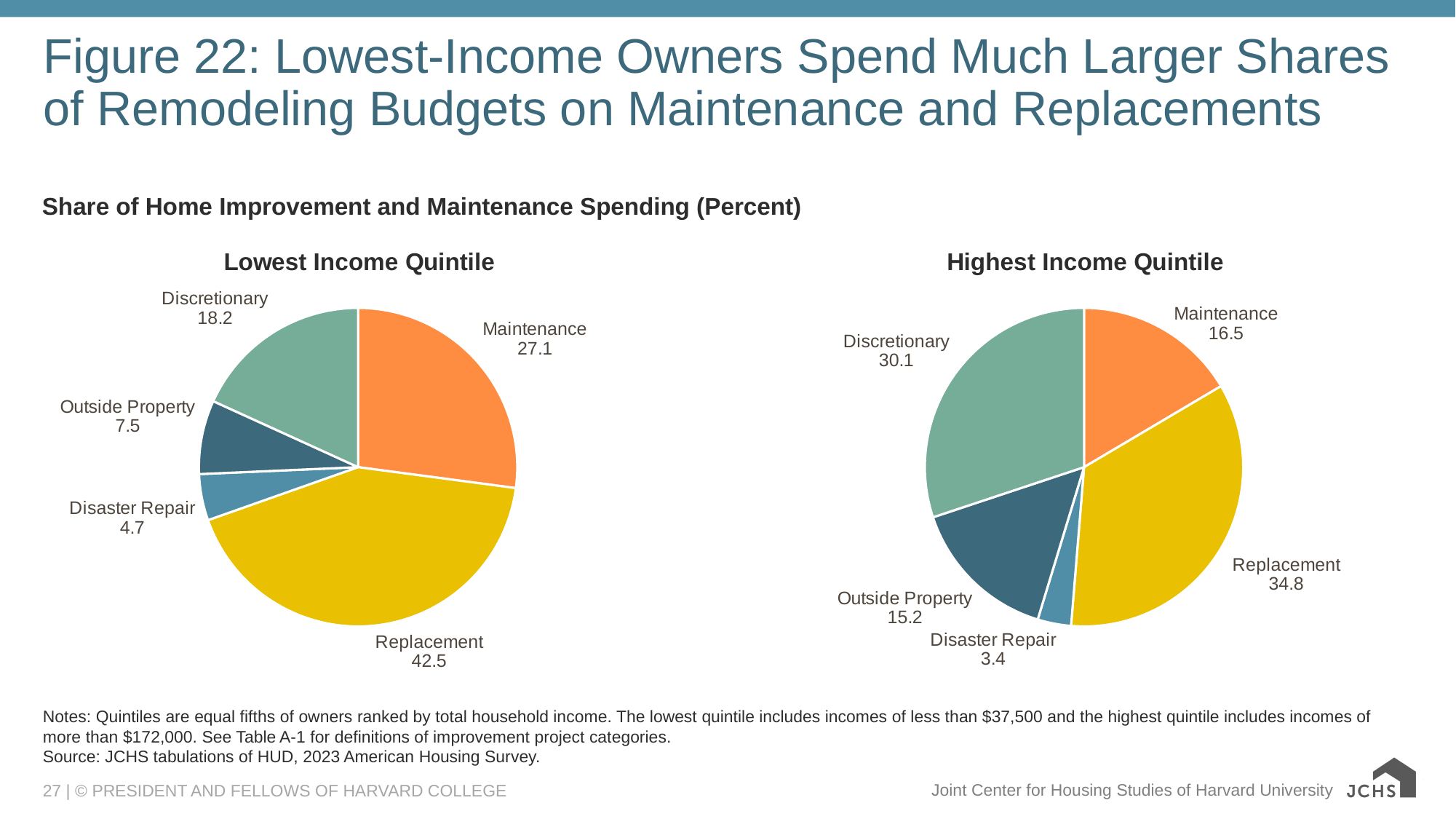
What is the difference between the Maintenance share in the Lowest Income Quintile chart and the Maintenance share in the Highest Income Quintile chart? 10.6 In the Lowest Income Quintile pie chart, which category has the largest share? Replacement What type of chart is used for the Highest Income Quintile? Pie chart In the Lowest Income Quintile pie chart, what share of spending goes to Replacement? 42.5 In the Highest Income Quintile pie chart, what is the value for Disaster Repair? 3.4 Which is larger: Outside Property in the Lowest Income Quintile chart or Outside Property in the Highest Income Quintile chart? Highest Income Quintile In the Highest Income Quintile pie chart, which category has the smallest share? Disaster Repair In the Highest Income Quintile pie chart, what share of spending goes to Discretionary? 30.1 How many categories are shown in the Lowest Income Quintile pie chart? 5 In the Lowest Income Quintile pie chart, what colour is the Replacement slice? Yellow What is the subtitle above the two pie charts? Share of Home Improvement and Maintenance Spending (Percent) In the Lowest Income Quintile pie chart, what is the difference between Discretionary and Outside Property? 10.7